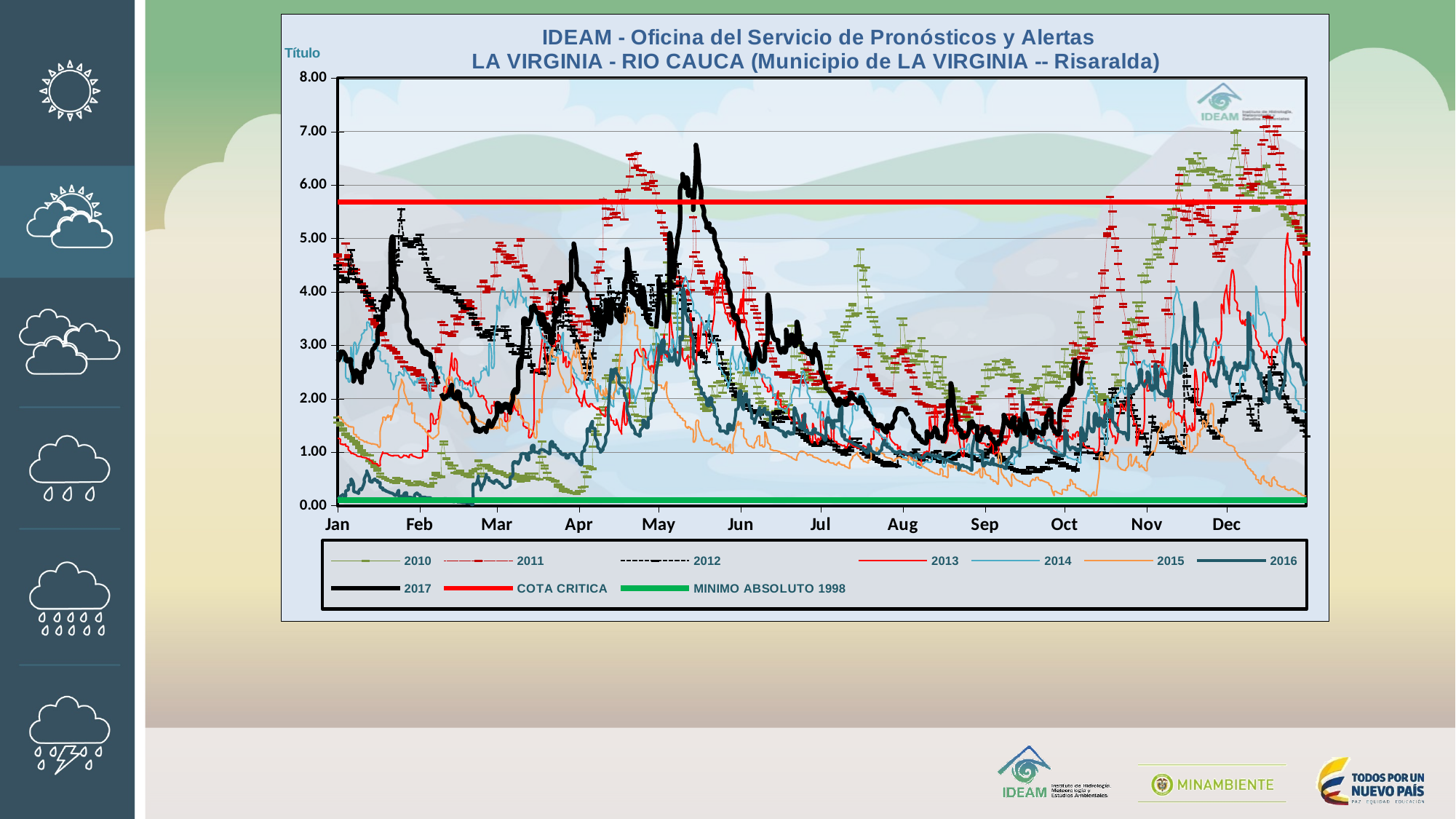
Is the value of the 2015 series at the end of December greater or less than 1.00? less Is the value of the 2010 series at the start of January greater or less than 2.00? less Which legend entry is drawn as a thick green line? MINIMO ABSOLUTO 1998 What kind of chart is shown on the slide? line chart What is the highest value shown on the y axis? 8.00 Is the COTA CRITICA line greater or less than 6.00? less How many months are labelled along the x axis? 12 What is the first line of the chart title? IDEAM - Oficina del Servicio de Pronósticos y Alertas How many series does the legend list? 10